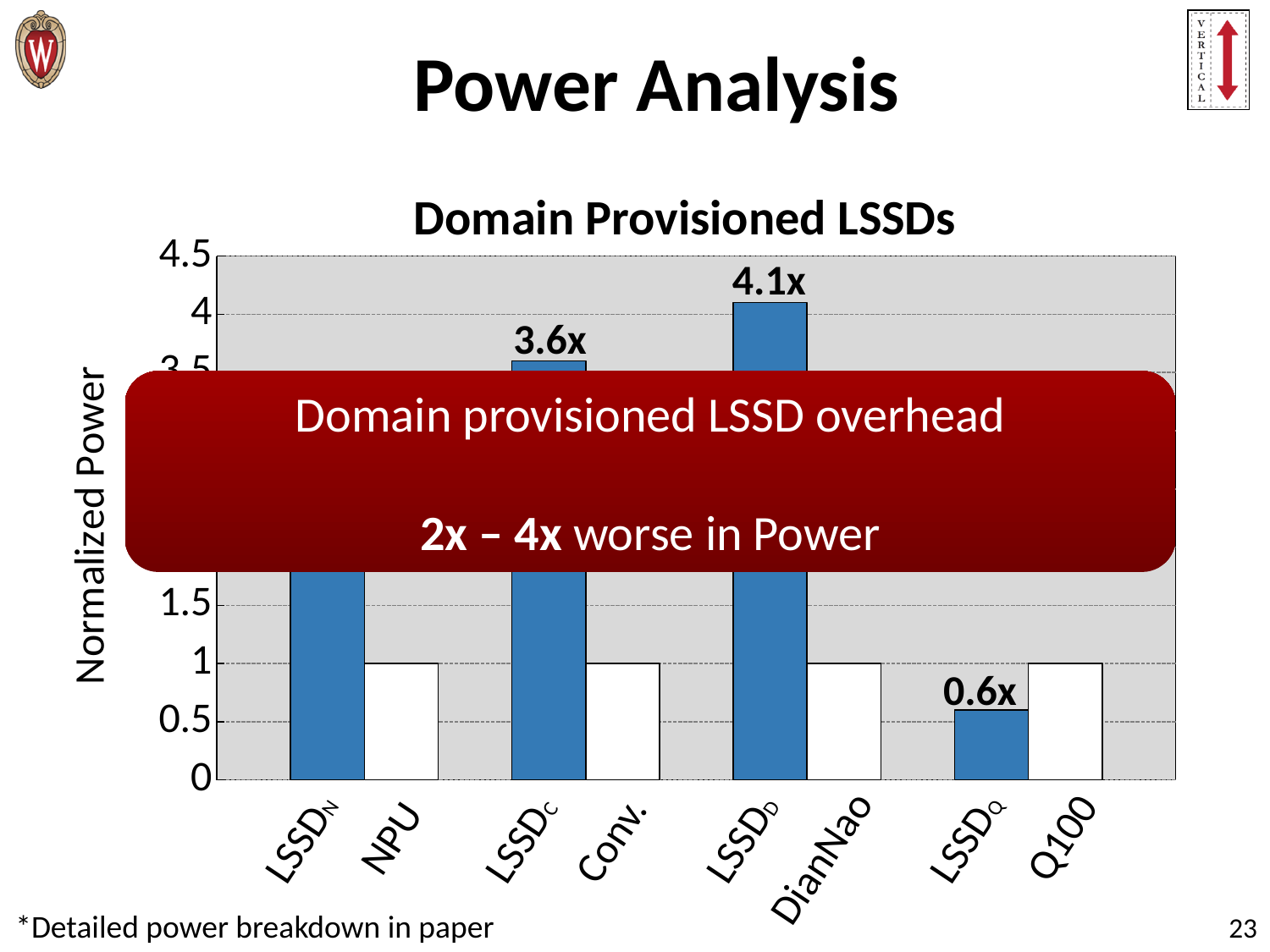
What is the normalized power value for LSSD_D? 4.1x Is the value for LSSD_N greater or less than 1.5? greater Which has a higher normalized power, LSSD_Q or Q100? Q100 What is the difference between the normalized power of LSSD_D and LSSD_C? 0.5x Which category has the highest normalized power? LSSD_D What is the label of the y-axis? Normalized Power What is the normalized power value for LSSD_Q? 0.6x What is the normalized power value for LSSD_C? 3.6x What is the title of the chart? Domain Provisioned LSSDs Which category has the lowest normalized power? LSSD_Q How many bars are plotted in the chart? 8 What type of chart is shown on the slide? bar chart